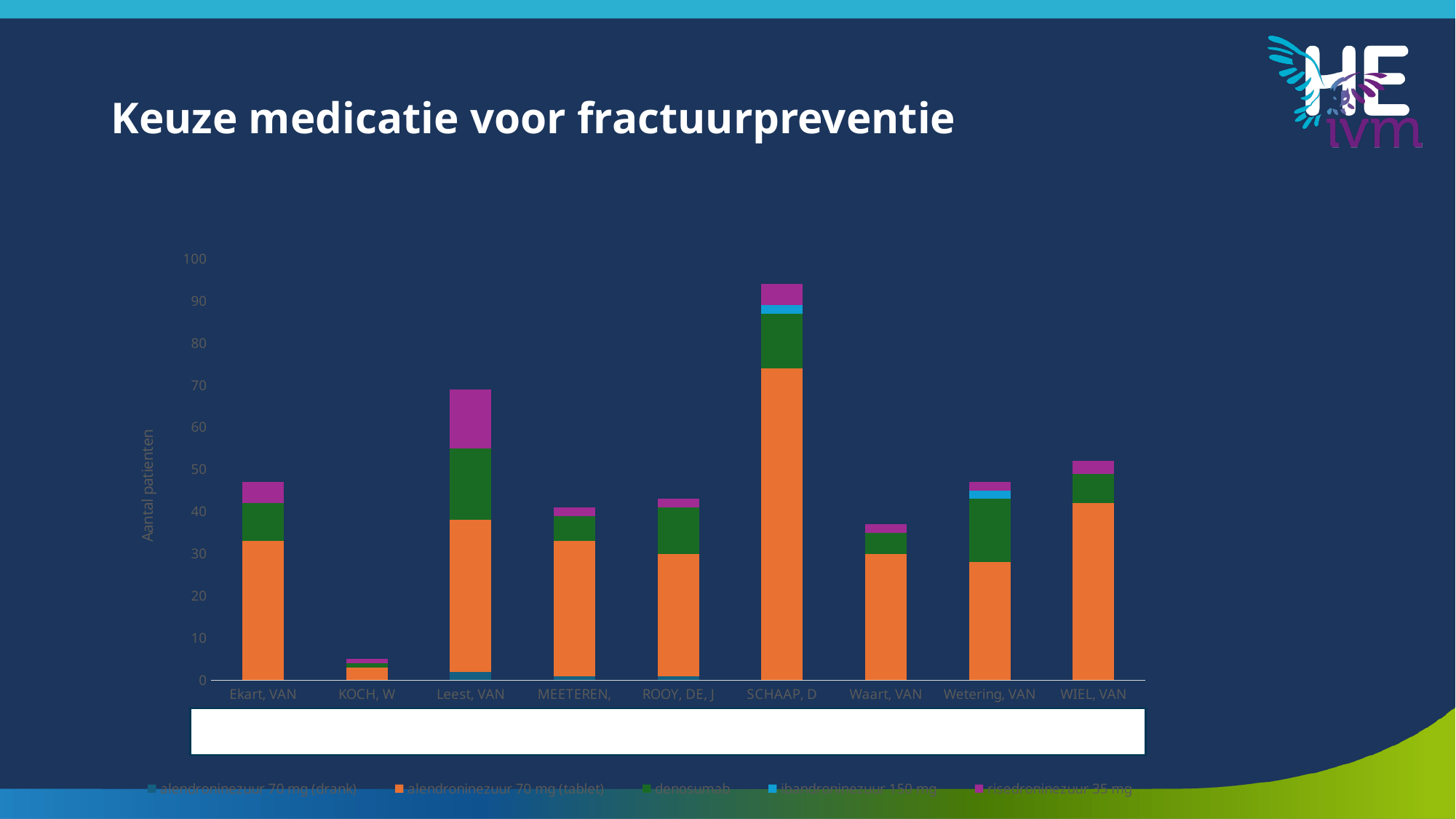
Is the total stacked bar for SCHAAP, D greater or less than 80? greater What is the label on the vertical axis of the chart? Aantal patienten Is the total stacked bar for Waart, VAN greater or less than 40? less Which category has the tallest stacked bar in the chart? SCHAAP, D How many categories (prescribers) are shown on the x axis of the chart? 9 Is the total stacked bar for KOCH, W greater or less than 10? less What kind of chart is shown on the slide? stacked bar chart What is the title of the slide containing the chart? Keuze medicatie voor fractuurpreventie How many series does the chart's legend list? 5 Which category has the shortest stacked bar in the chart? KOCH, W Which has the taller stacked bar, Leest, VAN or Ekart, VAN? Leest, VAN